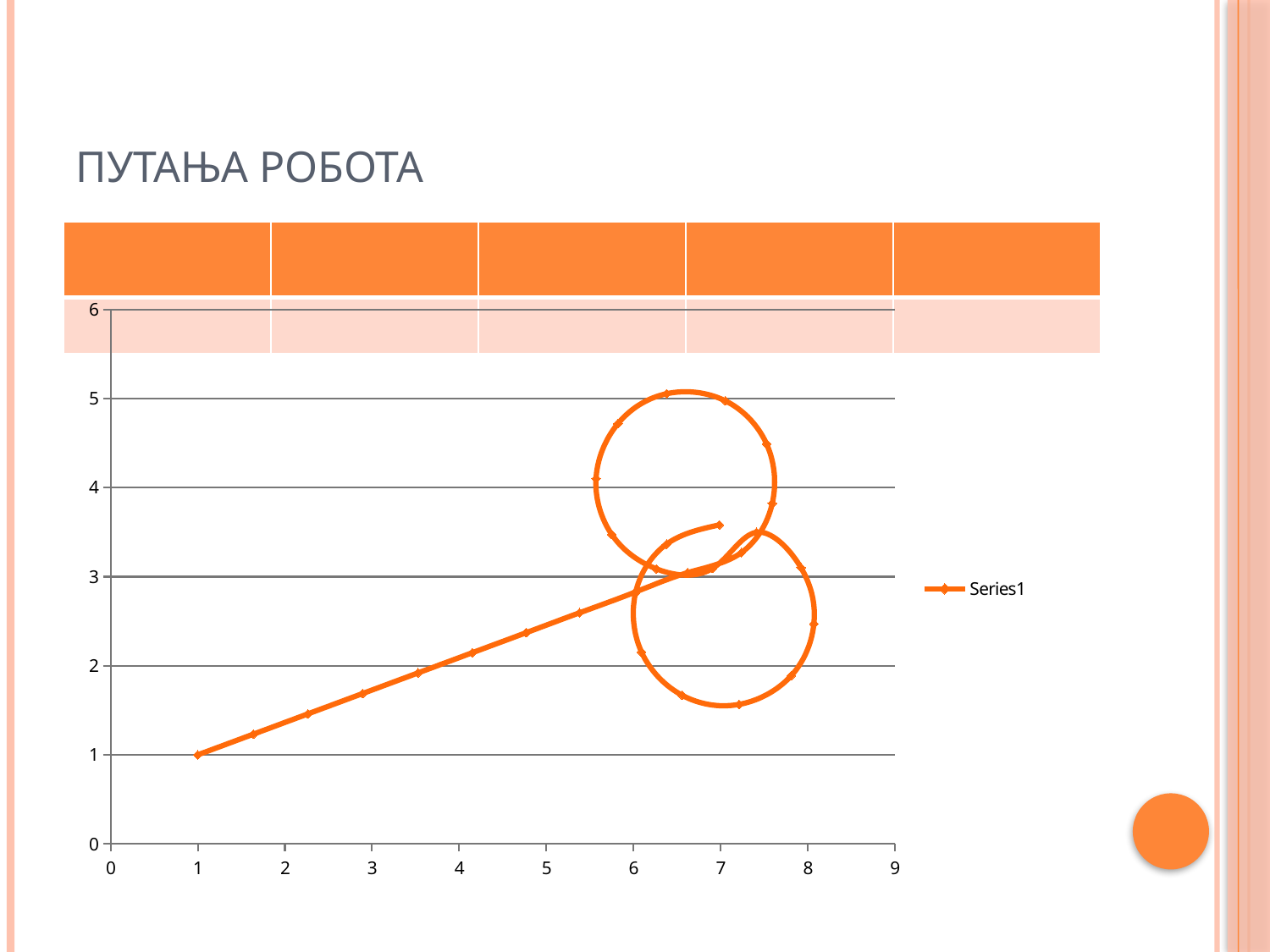
What is the name of the series shown in the legend? Series1 What kind of chart is shown on the slide? Scatter (line) chart Is the y value of the path at x = 4 greater or less than 3? less Is the x value of the path's starting point greater or less than 2? less Is the highest y value reached by the path greater or less than 4? greater What is the y value of the path's starting point at x = 1? 1 Does the path rise or fall as x increases from 1 to 6? rise How many series does the legend list? 1 What is the title of the slide containing the chart? ПУТАЊА РОБОТА